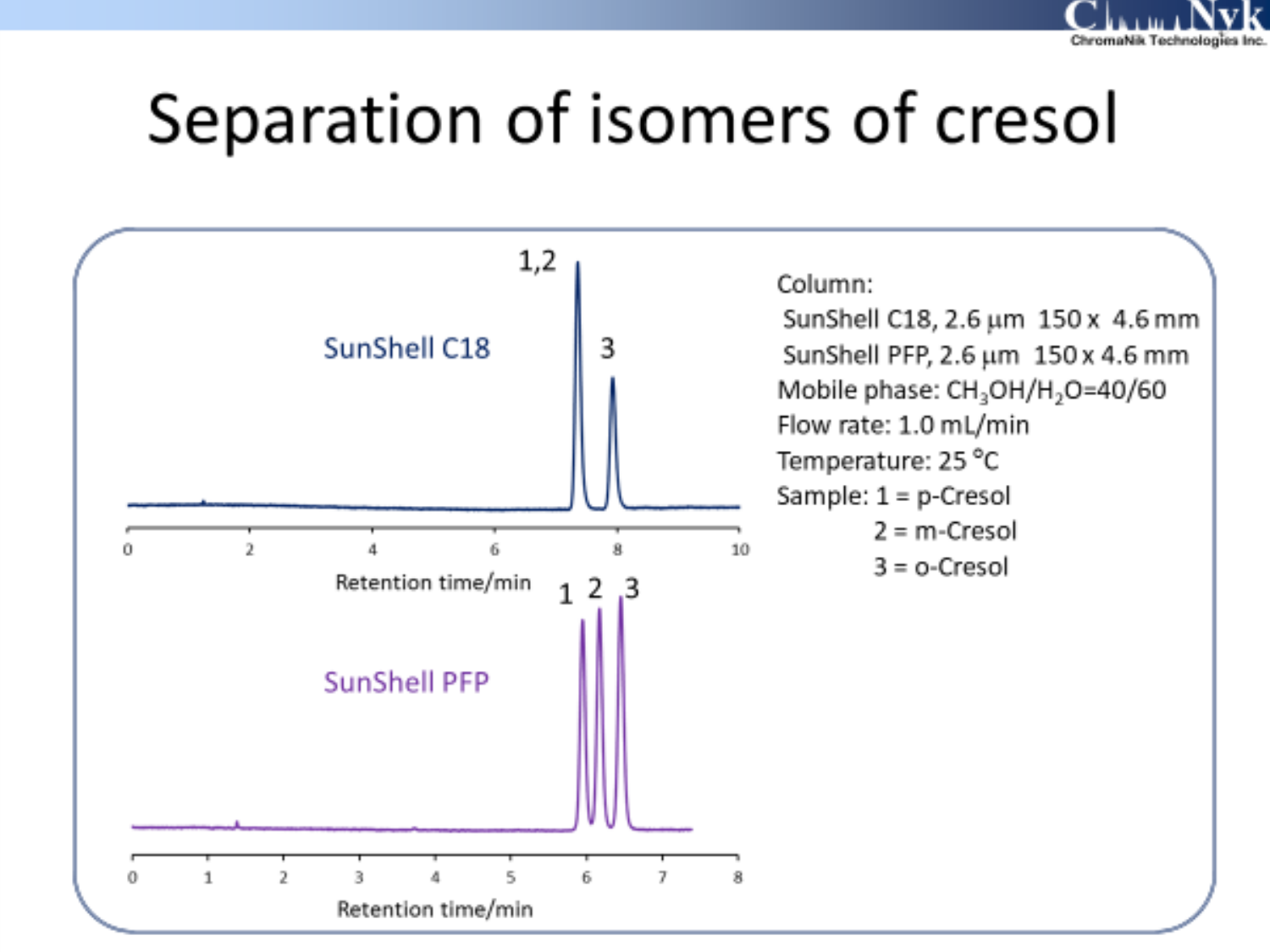
On the SunShell C18 chromatogram (top chart), which peak elutes later, peak 1,2 or peak 3? peak 3 How many labelled peaks are shown on the SunShell PFP chromatogram (bottom chart)? 3 What kind of chart is the SunShell C18 chromatogram (top chart)? line chart On the SunShell PFP chromatogram (bottom chart), is the retention time of peak 3 greater or less than 7 min? less What is the maximum value shown on the x axis of the SunShell C18 chromatogram (top chart)? 10 On the SunShell C18 chromatogram (top chart), is the retention time of peak 1,2 greater or less than 8 min? less On the SunShell C18 chromatogram (top chart), is the retention time of peak 3 greater or less than 6 min? greater On the SunShell PFP chromatogram (bottom chart), which labelled peak elutes first? 1 What is the x-axis label of the SunShell PFP chromatogram (bottom chart)? Retention time/min How many separate peaks are visible on the SunShell C18 chromatogram (top chart)? 2